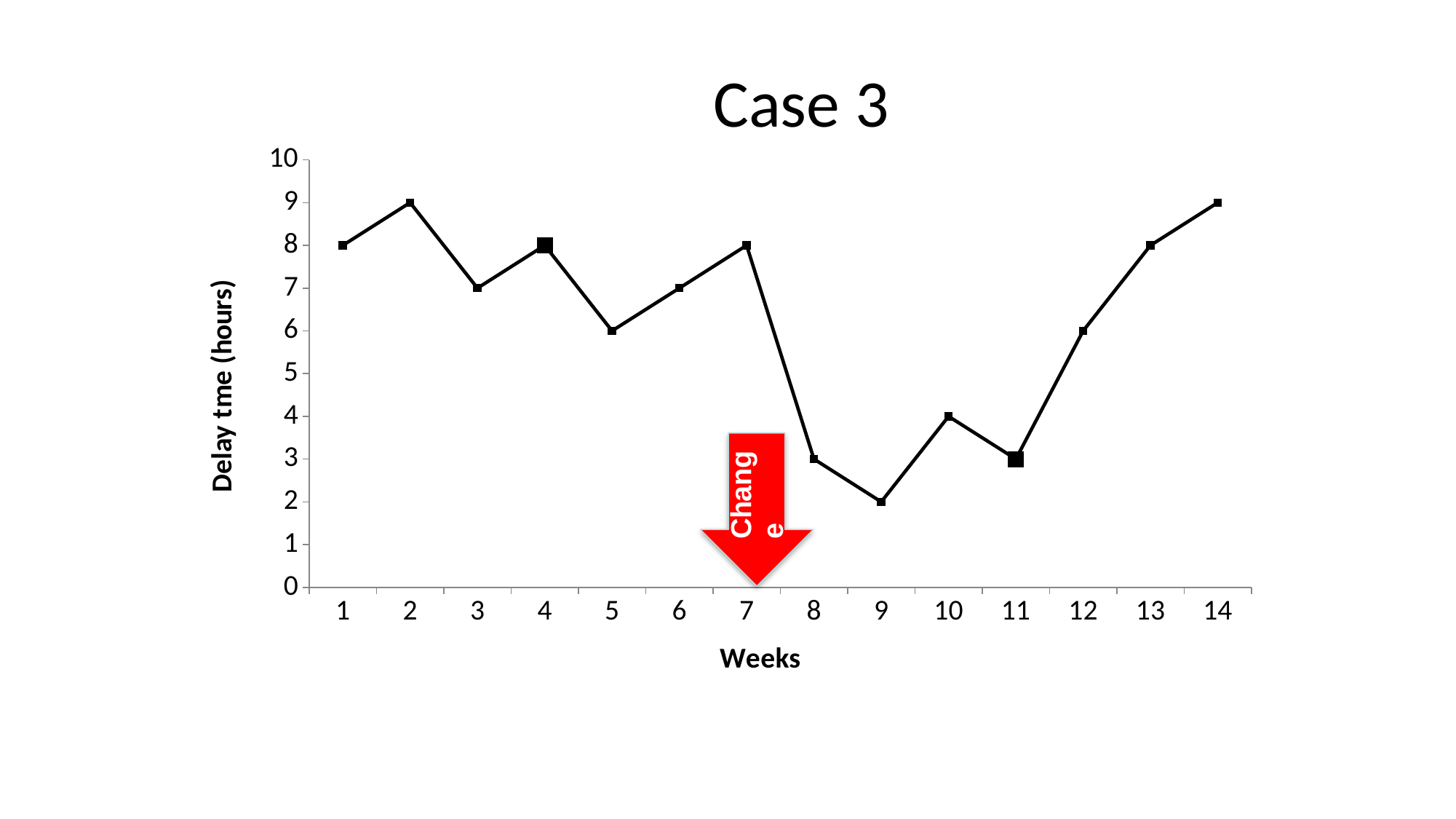
What type of chart is shown on the slide? line chart Is the delay time in week 13 greater or less than 5? greater What is the delay time in week 12? 6 What is the delay time in week 8? 3 What is the delay time in week 2? 9 In which week is the delay time lowest? 9 What is the difference in delay time between week 7 and week 8? 5 Which week has a larger delay time, week 5 or week 10? 5 What is the title of the chart? Case 3 How many weeks are plotted on the x axis? 14 What is the delay time in week 9? 2 Does the delay time rise or fall from week 9 to week 14? rise